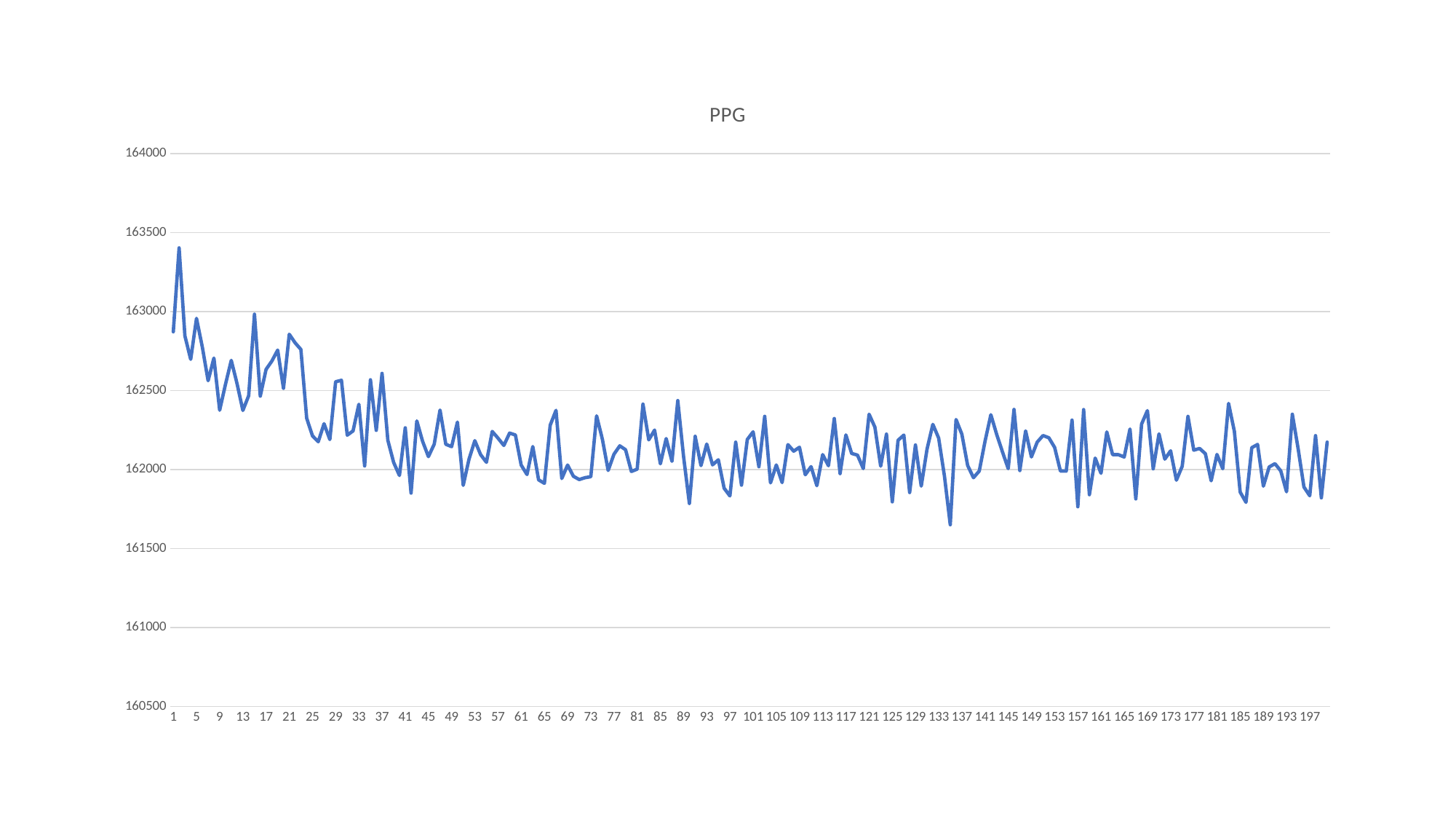
Are all plotted values greater or less than 163500? less What kind of chart is shown on the slide? line chart Is the value at x = 1 larger or smaller than the value at x = 41? larger Is the highest point on the line greater or less than 163000? greater Is the value at x = 1 greater or less than 162500? greater What is the highest value shown on the y axis? 164000 Overall, do the values rise or fall as you move from left to right along the x axis? fall What is the title of the chart? PPG